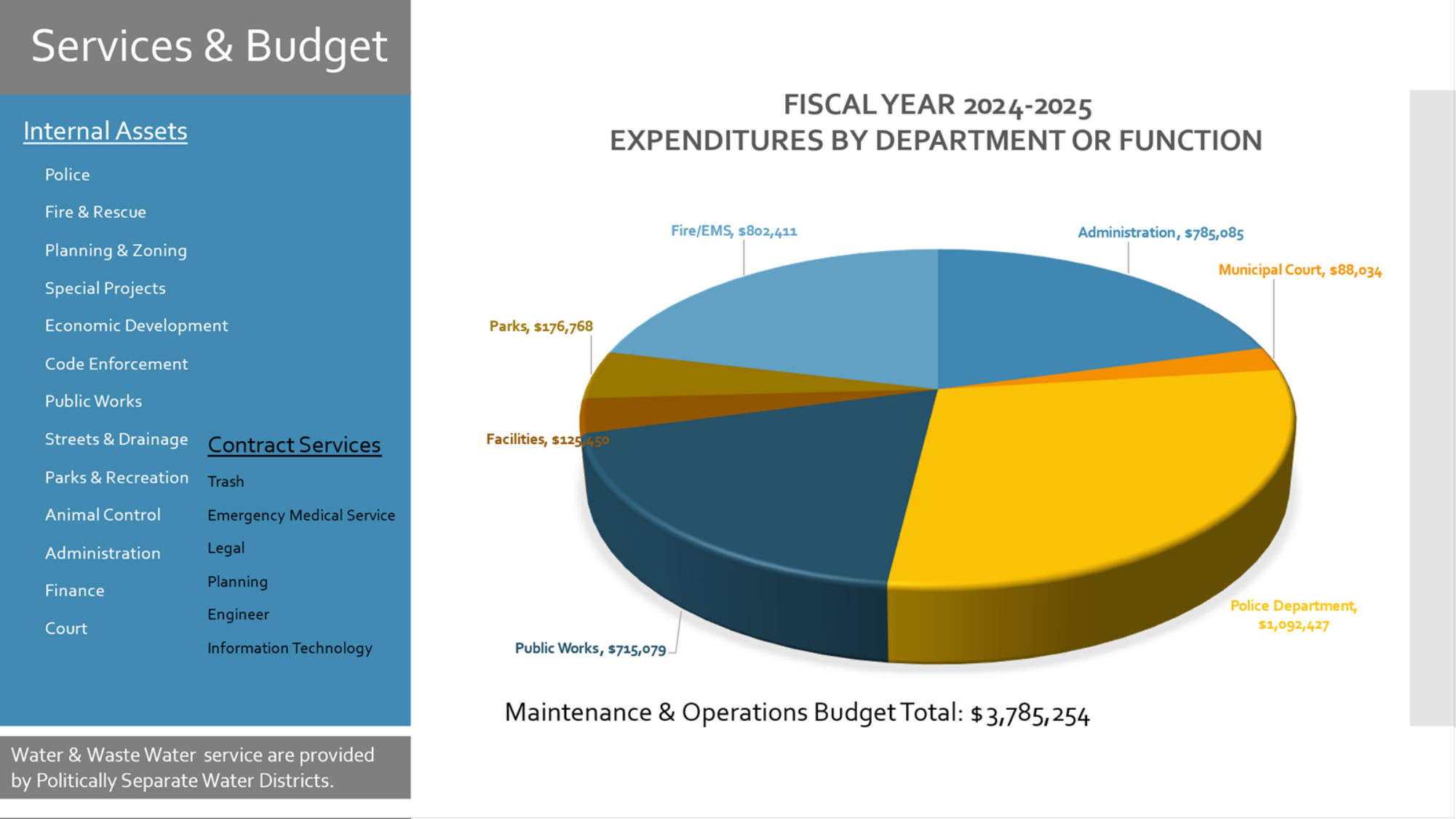
What is the expenditure for Fire/EMS? $802,411 What is the difference between the Parks and Facilities expenditures? $51,318 How much larger is the Police Department expenditure than the Public Works expenditure? $377,348 Which department or function has the largest expenditure? Police Department What is the expenditure for the Police Department? $1,092,427 Which is larger, the expenditure for Administration or for Public Works? Administration What is the title of the chart? FISCAL YEAR 2024-2025 EXPENDITURES BY DEPARTMENT OR FUNCTION What type of chart is shown on the slide? Pie chart What is the expenditure for Municipal Court? $88,034 Which department or function has the smallest expenditure? Municipal Court What is the expenditure for Public Works? $715,079 How many departments or functions are shown in the pie chart? 7